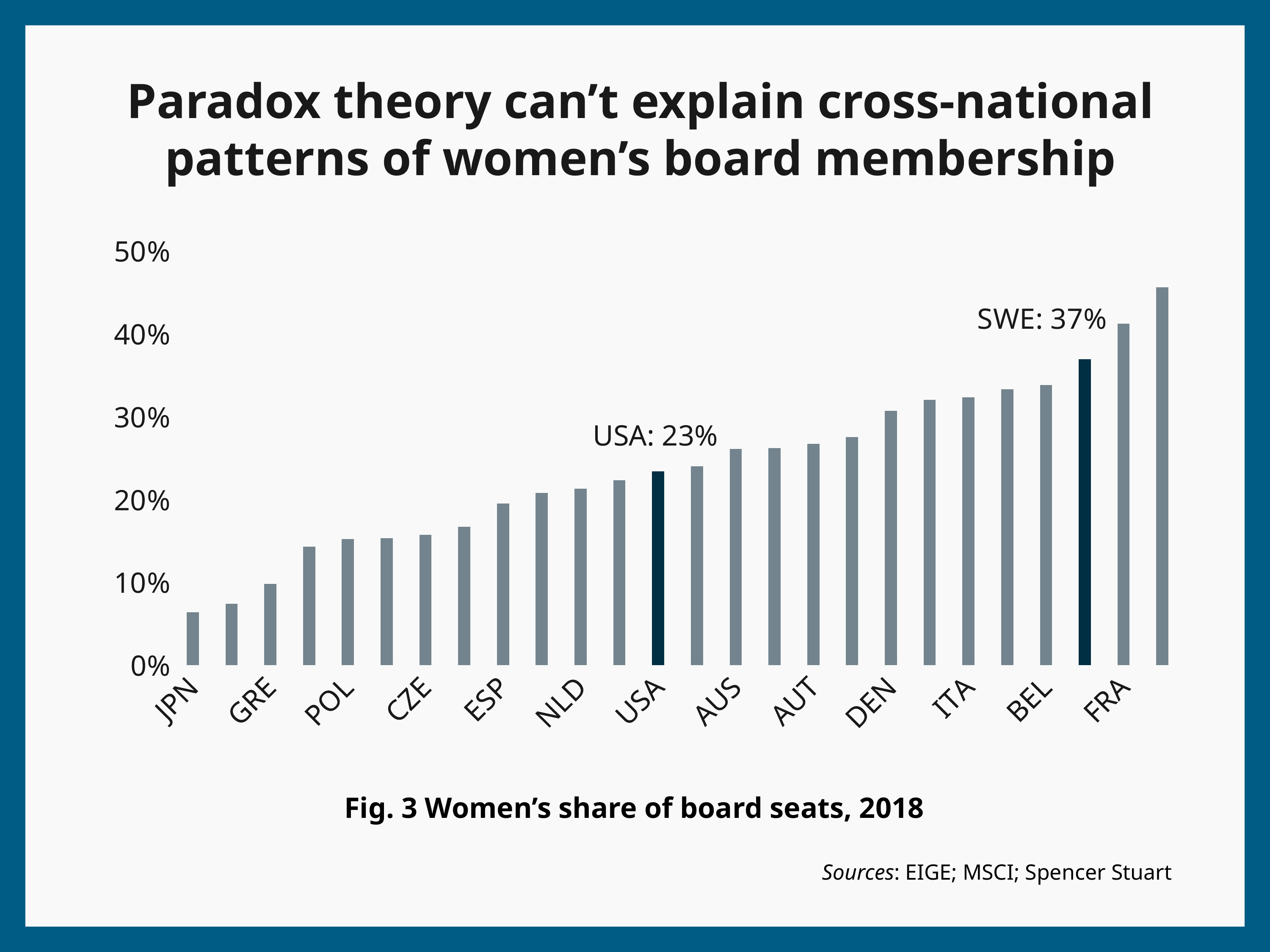
Is the value for JPN greater or less than 10%? less Which has the larger value, USA or SWE? SWE Which two countries' bars are highlighted in a darker colour? USA and SWE Do the values rise or fall from left to right along the x axis? rise What is the value shown for SWE? 37% Which labelled country has the lowest value? JPN What is the value shown for USA? 23% What kind of chart is shown on the slide? bar chart Which has the larger value, GRE or POL? POL Is the value for CZE greater or less than 20%? less Is the value for BEL greater or less than 30%? greater What is the difference between the values for SWE and USA? 14 percentage points